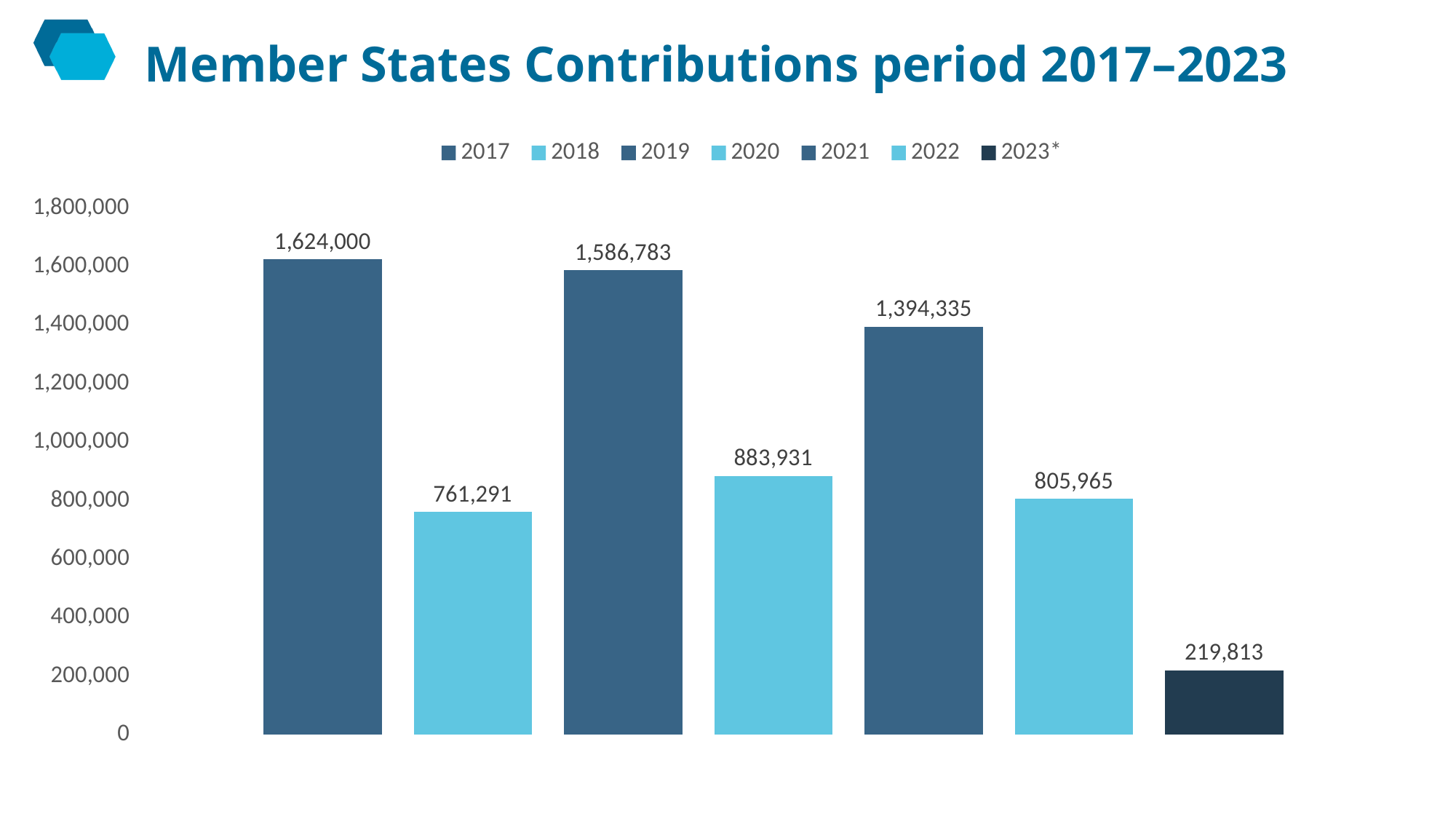
Which year has the highest contribution? 2017 What is the Member States contribution for 2020? 883,931 What kind of chart is shown on the slide? bar chart Is the value for 2022 greater or less than 1,000,000? less What is the Member States contribution for 2023*? 219,813 How many entries does the legend list? 7 How many bars are shown in the chart? 7 What is the difference between the 2017 and 2019 contributions? 37,217 What is the Member States contribution for 2017? 1,624,000 What is the difference between the 2020 and 2018 contributions? 122,640 Which year has the lowest contribution? 2023* Which year has the larger contribution, 2021 or 2022? 2021